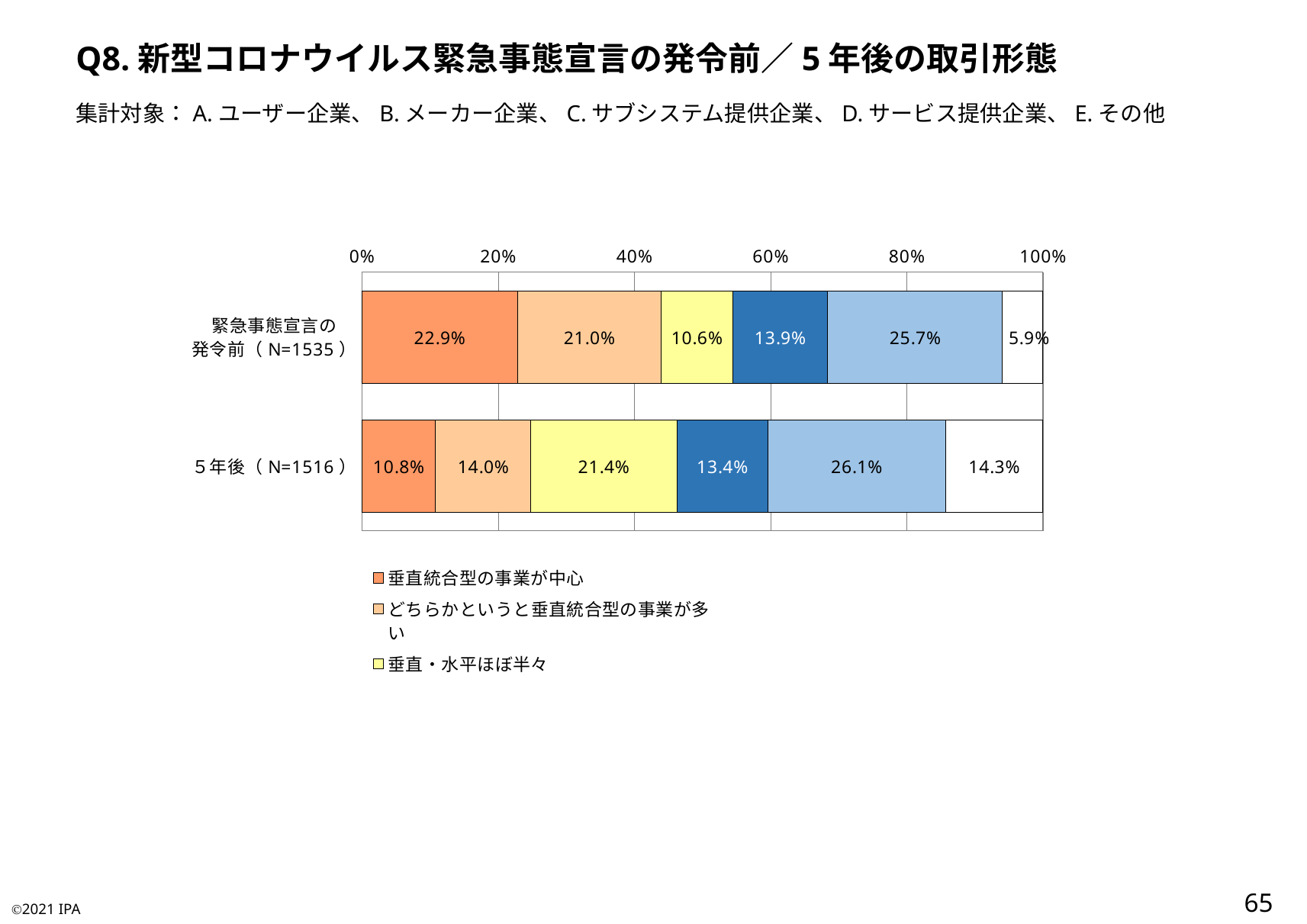
What is the value of 垂直統合型の事業が中心 for 緊急事態宣言の発令前 (N=1535)? 22.9% How many segments does each stacked bar contain? 6 Which segment has the smallest value in the 5年後 (N=1516) bar? 10.8% (垂直統合型の事業が中心) Which segment has the largest value in the 緊急事態宣言の発令前 (N=1535) bar? 25.7% (light blue segment) Which bar has the larger value for 垂直・水平ほぼ半々, 緊急事態宣言の発令前 or 5年後? 5年後 How many bars (categories) are shown in the chart? 2 What is the value of 垂直・水平ほぼ半々 for 5年後 (N=1516)? 21.4% What is the value of the rightmost (white) segment of the 5年後 (N=1516) bar? 14.3% By how many percentage points does 垂直統合型の事業が中心 differ between 緊急事態宣言の発令前 and 5年後? 12.1 percentage points By how many percentage points is 垂直・水平ほぼ半々 higher for 5年後 than for 緊急事態宣言の発令前? 10.8 percentage points What kind of chart is shown on the slide? Stacked horizontal bar chart What is the value of どちらかというと垂直統合型の事業が多い for 5年後 (N=1516)? 14.0%